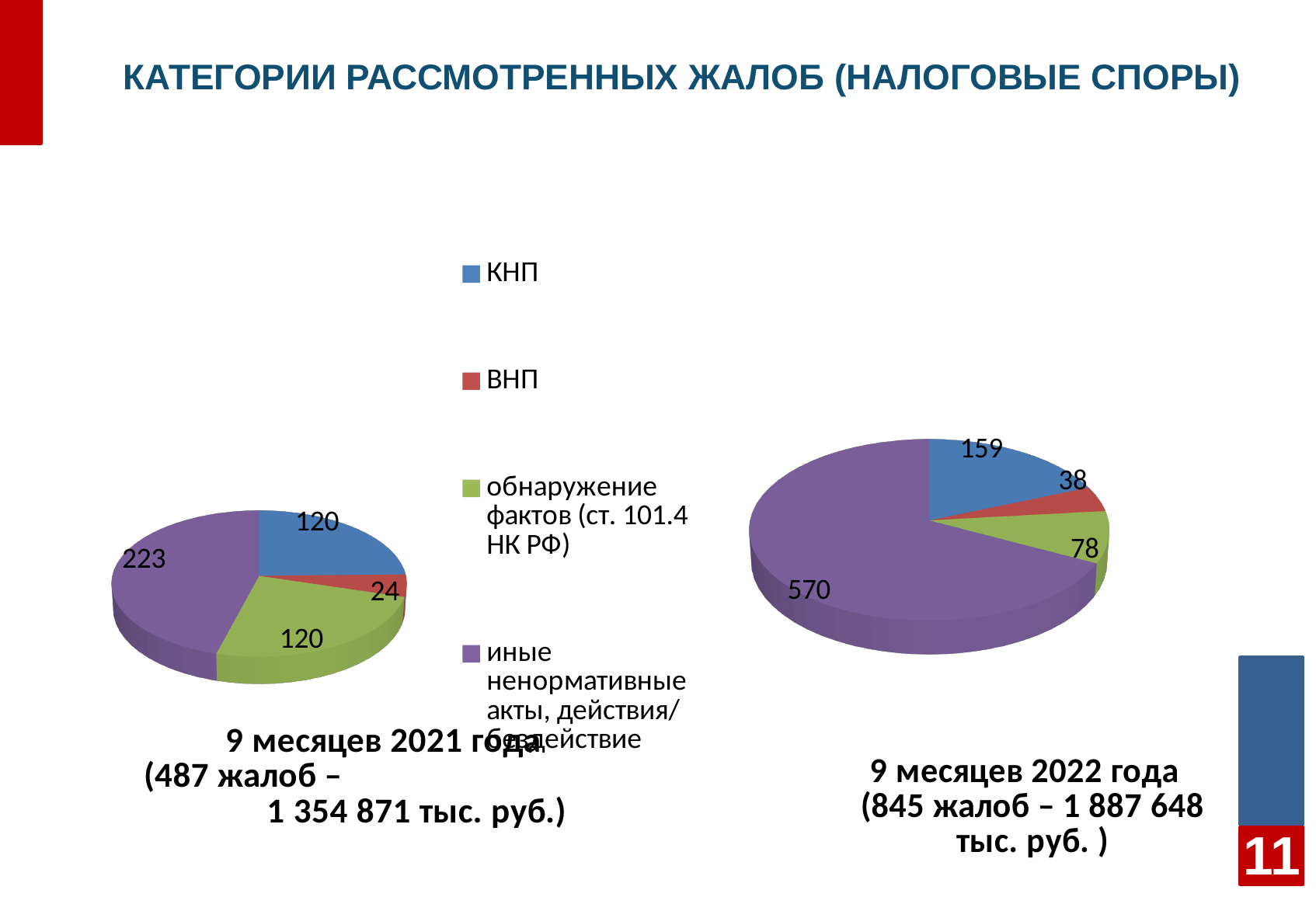
In the pie chart for 9 месяцев 2022 года, what is the value for иные ненормативные акты, действия/бездействие? 570 In the pie chart for 9 месяцев 2021 года, what is the value for обнаружение фактов (ст. 101.4 НК РФ)? 120 What is the total of all slices in the pie chart for 9 месяцев 2021 года? 487 In the pie chart for 9 месяцев 2021 года, what is the value for КНП? 120 What type of chart is used on this slide? Pie chart In the pie chart for 9 месяцев 2022 года, what is the value for ВНП? 38 How much larger is the value for иные ненормативные акты, действия/бездействие in the 9 месяцев 2022 года chart than in the 9 месяцев 2021 года chart? 347 How many slices does the pie chart for 9 месяцев 2021 года have? 4 In the pie chart for 9 месяцев 2021 года, which category has the smallest slice? ВНП In the pie chart for 9 месяцев 2022 года, which is larger: КНП or обнаружение фактов (ст. 101.4 НК РФ)? КНП In the pie chart for 9 месяцев 2022 года, what is the difference between the КНП value and the ВНП value? 121 In the pie chart for 9 месяцев 2022 года, which category has the largest slice? иные ненормативные акты, действия/бездействие